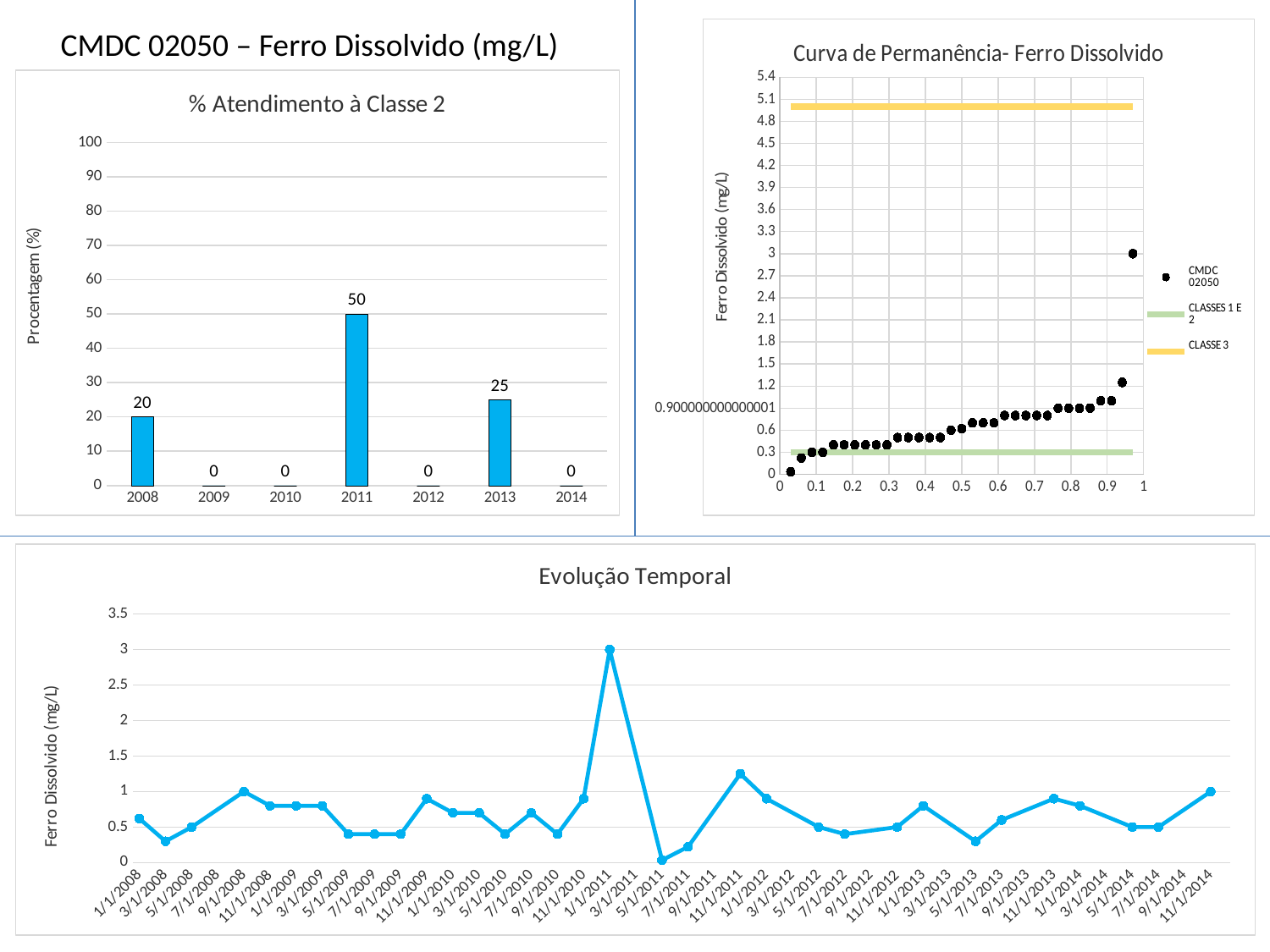
In the '% Atendimento à Classe 2' chart, how many years are shown on the x axis? 7 How many series does the legend of the 'Curva de Permanência- Ferro Dissolvido' chart list? 3 What kind of chart is 'Evolução Temporal'? line chart In the '% Atendimento à Classe 2' chart, what is the difference between the values for 2011 and 2008? 30 In the '% Atendimento à Classe 2' chart, what is the value for 2011? 50 In the '% Atendimento à Classe 2' chart, what is the value for 2013? 25 In the 'Evolução Temporal' chart, is the value for 1/1/2011 greater or less than 2.5? greater In the '% Atendimento à Classe 2' chart, which is larger, the value for 2008 or the value for 2013? 2013 In the '% Atendimento à Classe 2' chart, how many years have a value of 0? 4 What kind of chart is '% Atendimento à Classe 2'? bar chart In the '% Atendimento à Classe 2' chart, which year has the highest value? 2011 What is the y-axis title of the 'Evolução Temporal' chart? Ferro Dissolvido (mg/L)